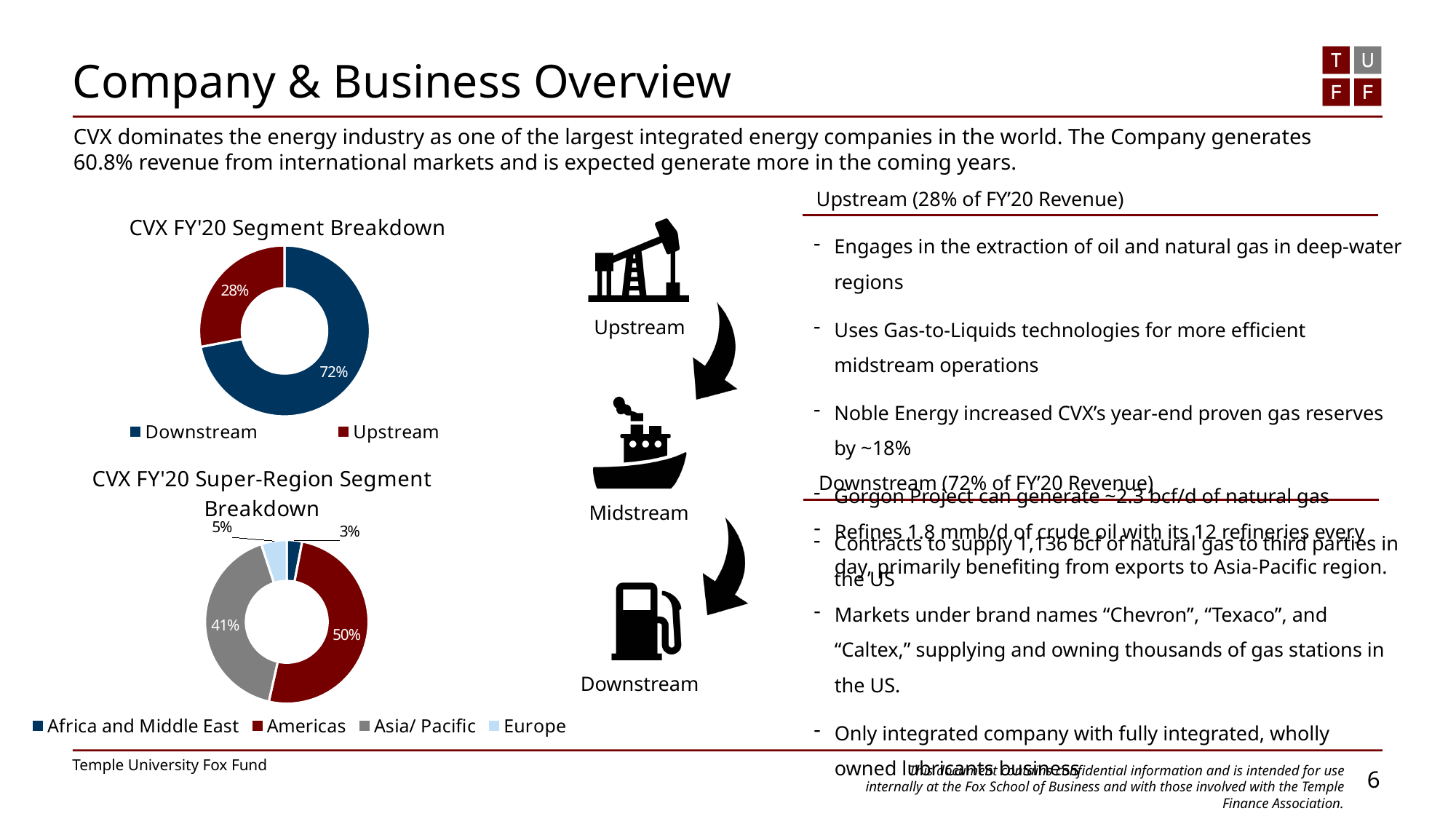
In the CVX FY'20 Segment Breakdown chart, which segment has the larger share? Downstream In the CVX FY'20 Segment Breakdown chart, what share of revenue is Upstream? 28% In the CVX FY'20 Super-Region Segment Breakdown chart, what is the difference in percentage points between Americas and Asia/ Pacific? 9 In the CVX FY'20 Super-Region Segment Breakdown chart, what share does Europe have? 5% In the CVX FY'20 Super-Region Segment Breakdown chart, which region has the smallest share? Africa and Middle East In the CVX FY'20 Segment Breakdown chart, what is the difference in percentage points between Downstream and Upstream? 44 How many regions are shown in the CVX FY'20 Super-Region Segment Breakdown chart? 4 In the CVX FY'20 Super-Region Segment Breakdown chart, what share does Americas have? 50% In the CVX FY'20 Super-Region Segment Breakdown chart, which region has the largest share? Americas In the CVX FY'20 Super-Region Segment Breakdown chart, what share does Asia/ Pacific have? 41% What type of chart is the CVX FY'20 Segment Breakdown? Donut (pie) chart In the CVX FY'20 Segment Breakdown chart, what share of revenue is Downstream? 72%